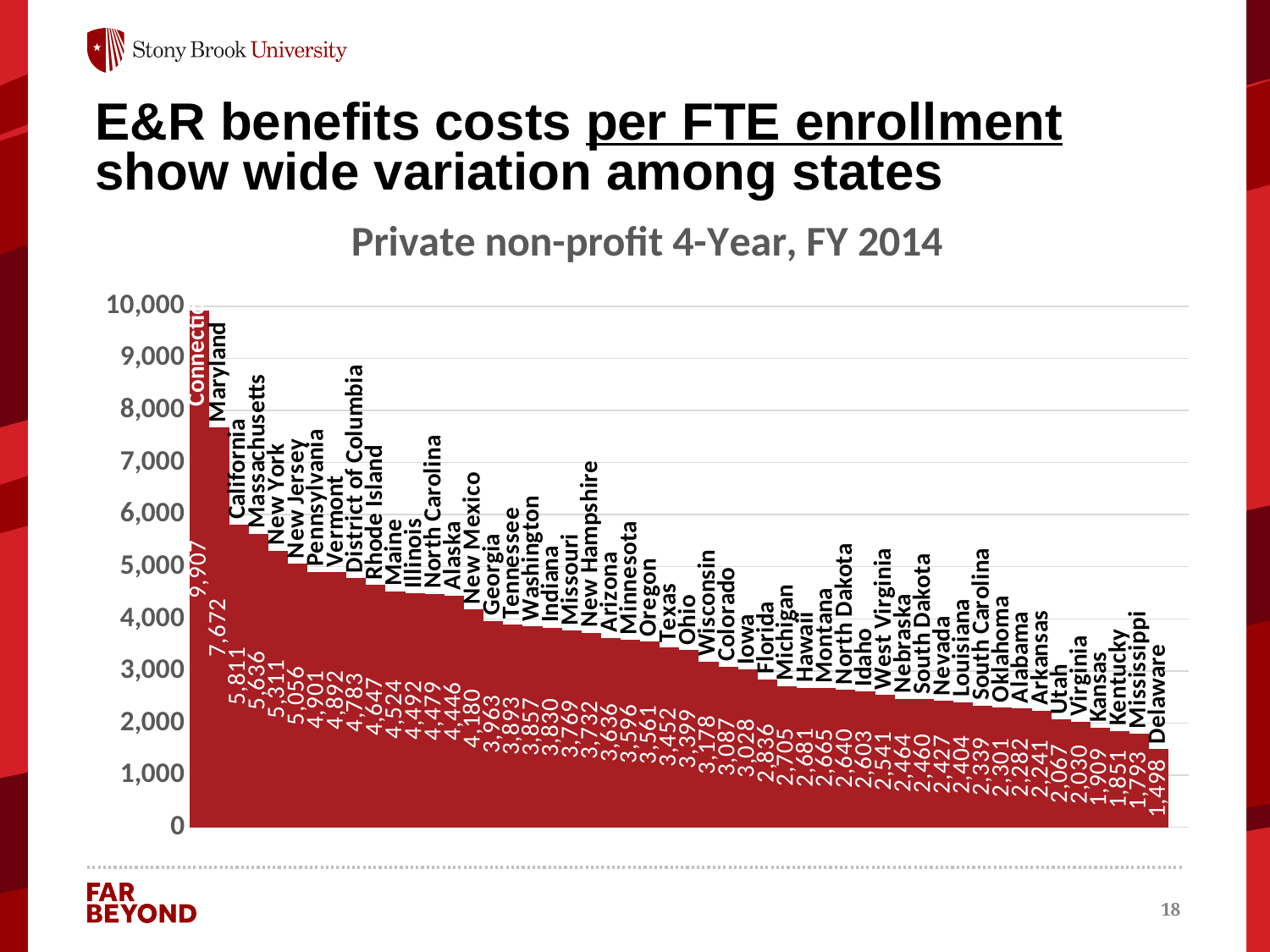
What is the value shown for Delaware? 1,498 Which state has the lowest E&R benefits cost per FTE enrollment? Delaware How many states or jurisdictions are plotted in the chart? 50 What kind of chart is shown on the slide? Bar chart Which has a higher value, California or New York? California What is the value shown for Texas? 3,452 What is the E&R benefits cost per FTE enrollment for Connecticut? 9,907 What is the difference between the values for Connecticut and Maryland? 2,235 Is the value for Georgia greater or less than 3,000? greater Which state has the highest E&R benefits cost per FTE enrollment? Connecticut Do the values rise or fall moving from left to right along the x axis? Fall What is the value shown for Maryland? 7,672